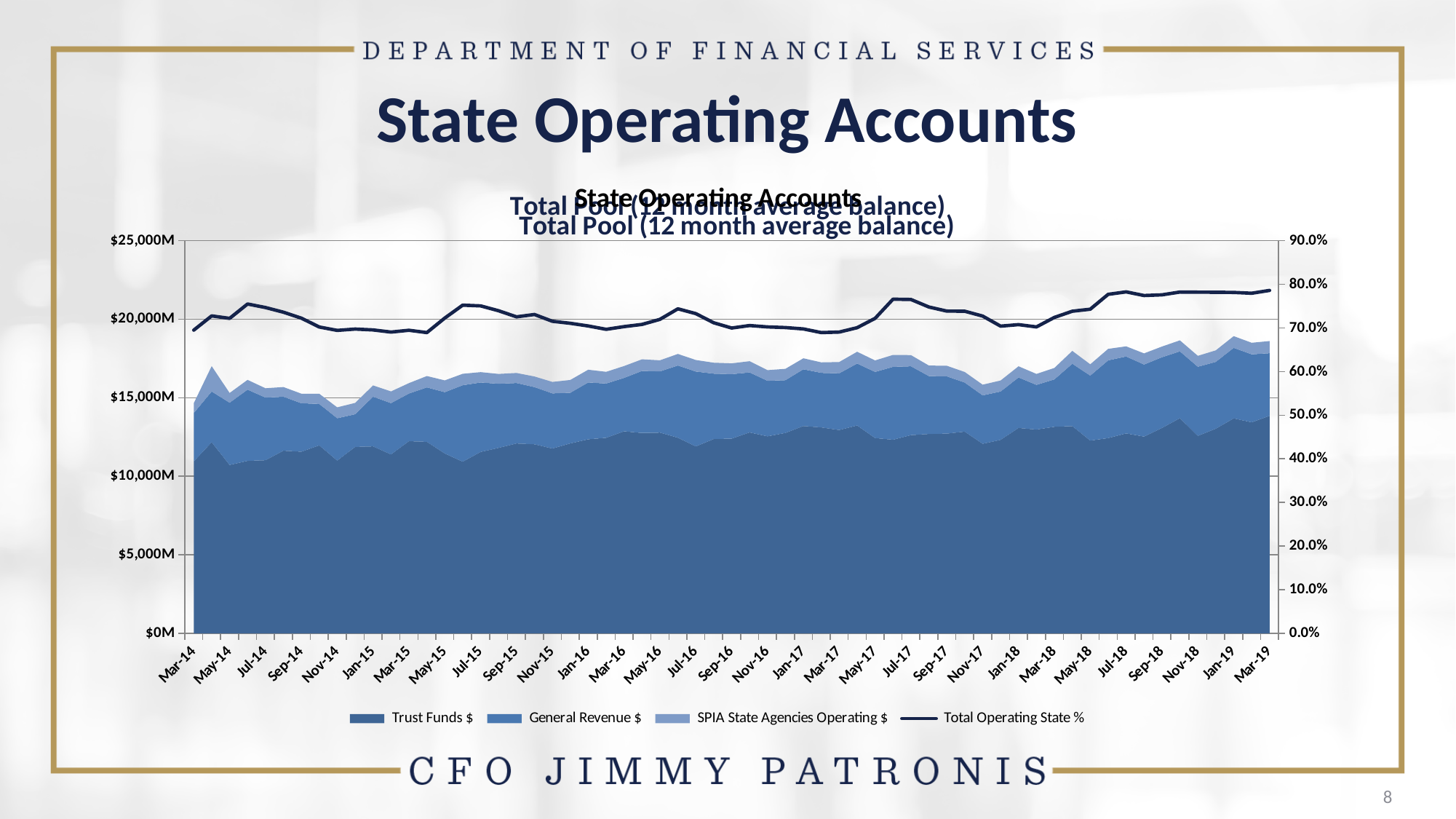
How many series does the legend list? 4 Which series makes up the largest part of the stacked area throughout the chart? Trust Funds $ Is the Trust Funds $ value for Mar-19 greater or less than $10,000M? greater Is the Total Operating State % value for Mar-19 greater or less than 70.0%? greater Is the Total Operating State % higher in Jul-17 or in Nov-17? Jul-17 Is the total stacked balance for Mar-19 greater or less than $20,000M? less What is the highest value shown on the left vertical axis? $25,000M Which series is plotted as a line rather than an area? Total Operating State % What kind of chart is shown on the slide? Stacked area chart with a line Does the Total Operating State % line overall rise or fall from Mar-14 to Mar-19? rise